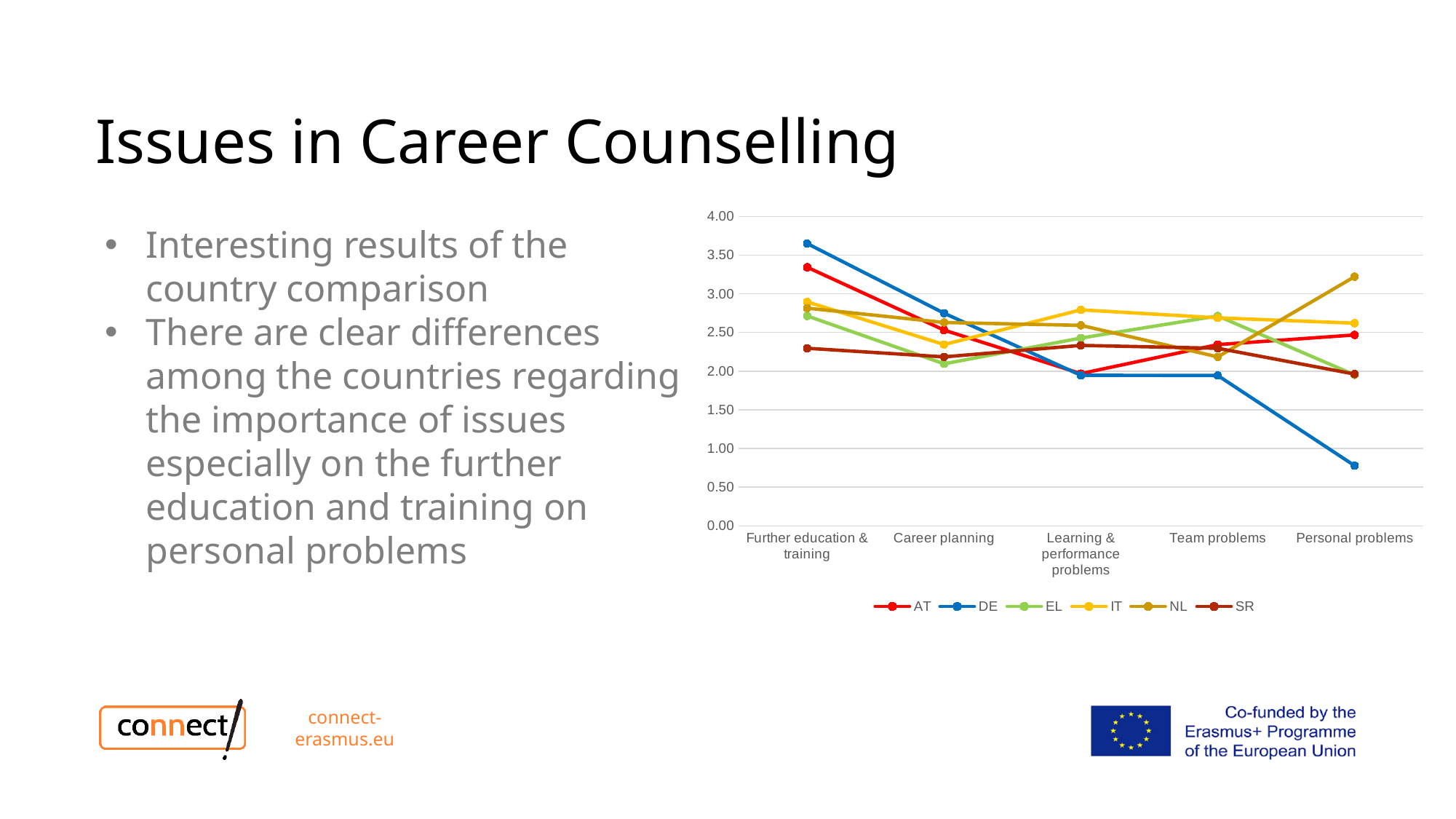
Which series has the highest value for Personal problems? NL How many categories are shown on the x axis of the chart? 5 Is the value for AT at Further education & training greater or less than 3.00? greater Which series has the lowest value for Personal problems? DE Is the value for DE at Personal problems greater or less than 1.00? less Is the value for DE at Further education & training greater or less than 3.50? greater Which is larger at Further education & training, the value for DE or the value for SR? DE How many series does the chart legend list? 6 Which series has the highest value for Further education & training? DE Does the DE line rise or fall from Further education & training to Personal problems? fall What kind of chart is shown on the slide? line chart Which series is drawn in blue in the chart legend? DE